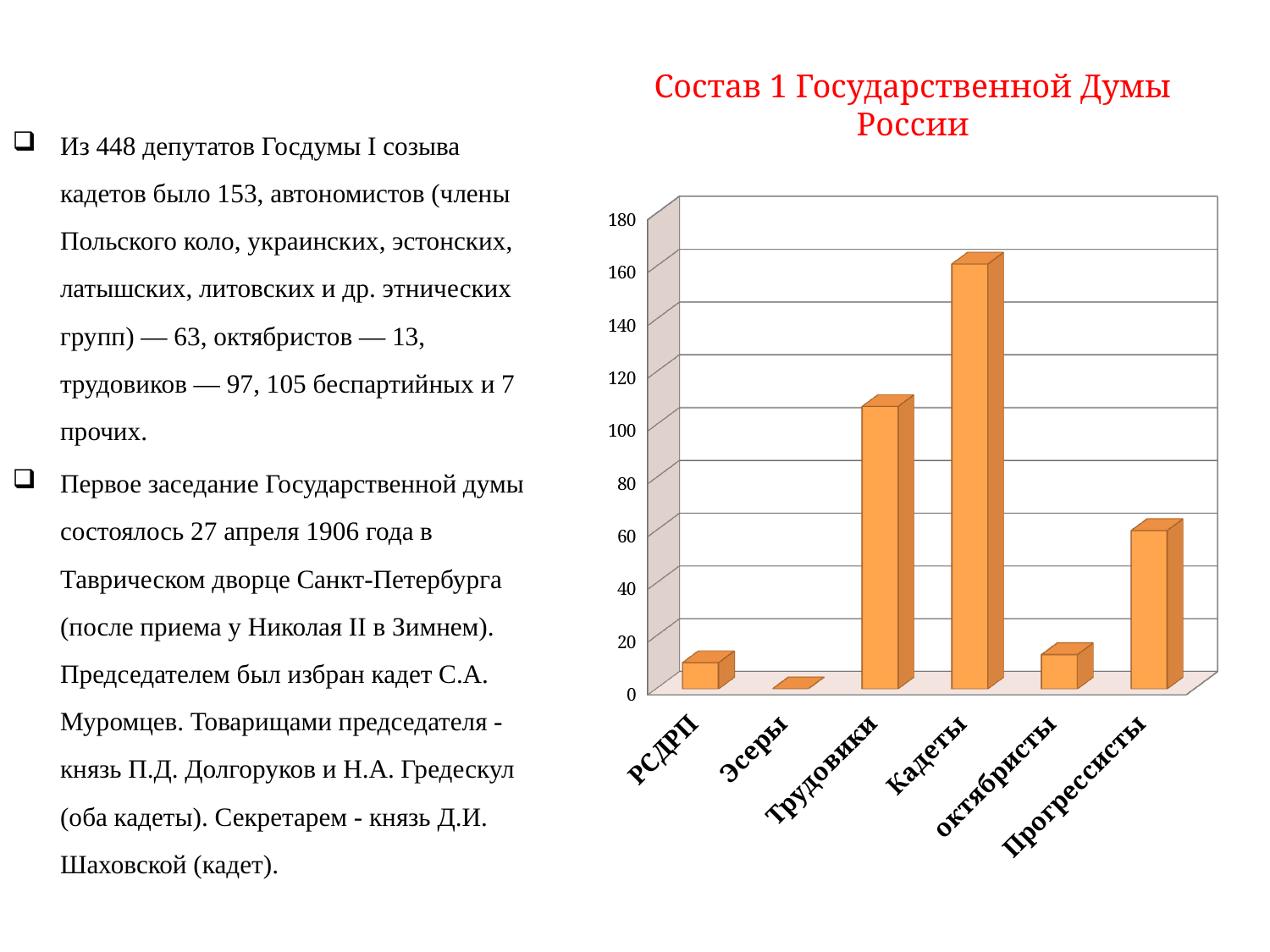
Which is larger, the value for Кадеты or the value for Трудовики? Кадеты Which category has the highest value in the chart? Кадеты Is the value for Прогрессисты greater or less than 40? greater Is the value for РСДРП greater or less than 20? less Is the value for Трудовики greater or less than 80? greater What kind of chart is shown on the slide? bar chart Which is larger, the value for Трудовики or the value for Прогрессисты? Трудовики What is the title of the chart? Состав 1 Государственной Думы России Which category has the lowest value in the chart? Эсеры How many categories are shown on the x axis of the chart? 6